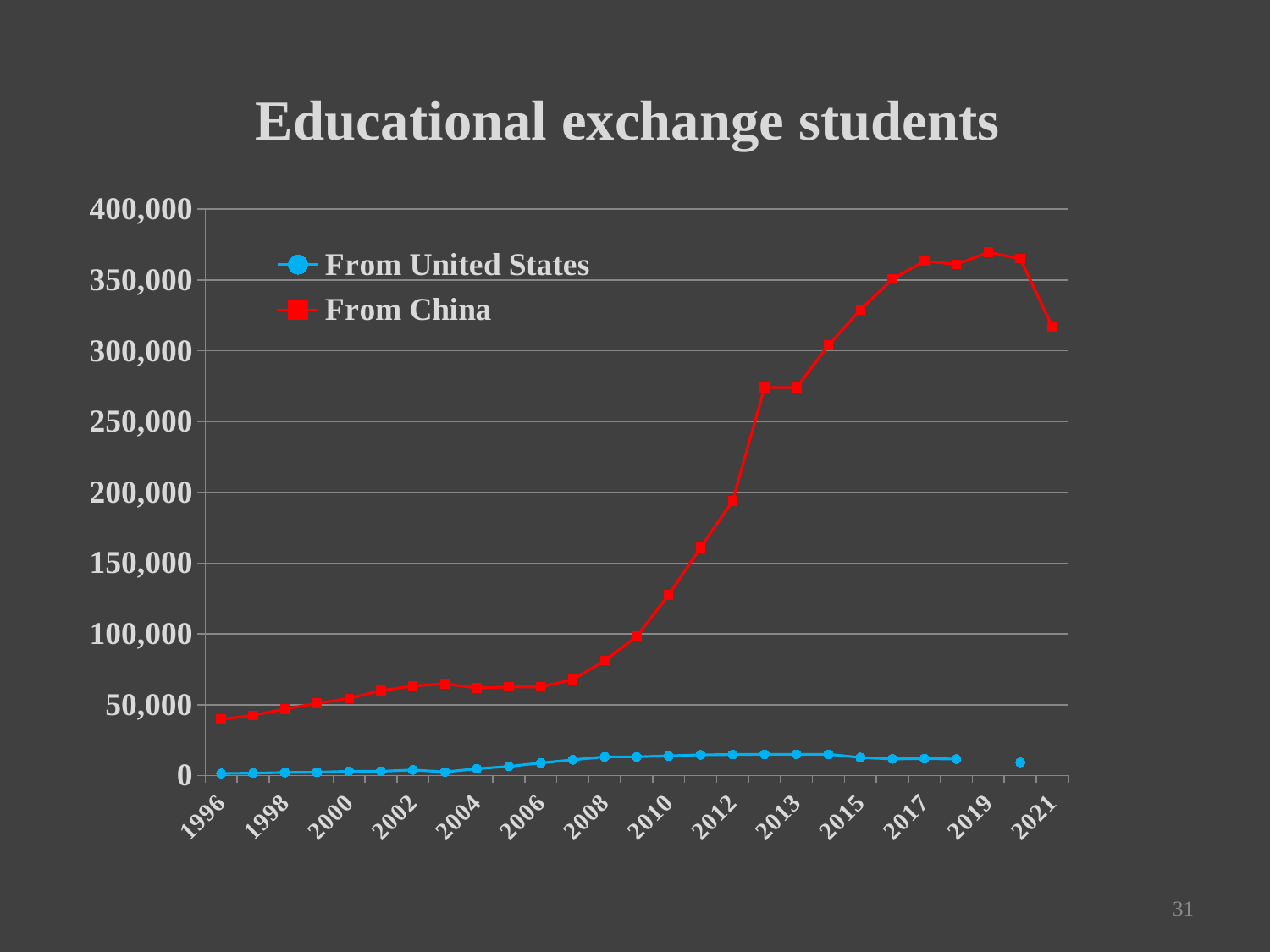
Does the From China series generally rise or fall from 1996 to 2019? Rise Which series has the larger value in 2010, From United States or From China? From China What kind of chart is shown on the slide? Line chart Is the value for From China in 2013 greater or less than 250,000? greater What is the title of the chart? Educational exchange students Is the value for From United States in 2012 greater or less than 50,000? less Is the value for From China in 2021 greater or less than 300,000? greater What are the two series named in the legend? From United States and From China How many series does the legend list? 2 Does the From China series rise or fall from 2019 to 2021? Fall